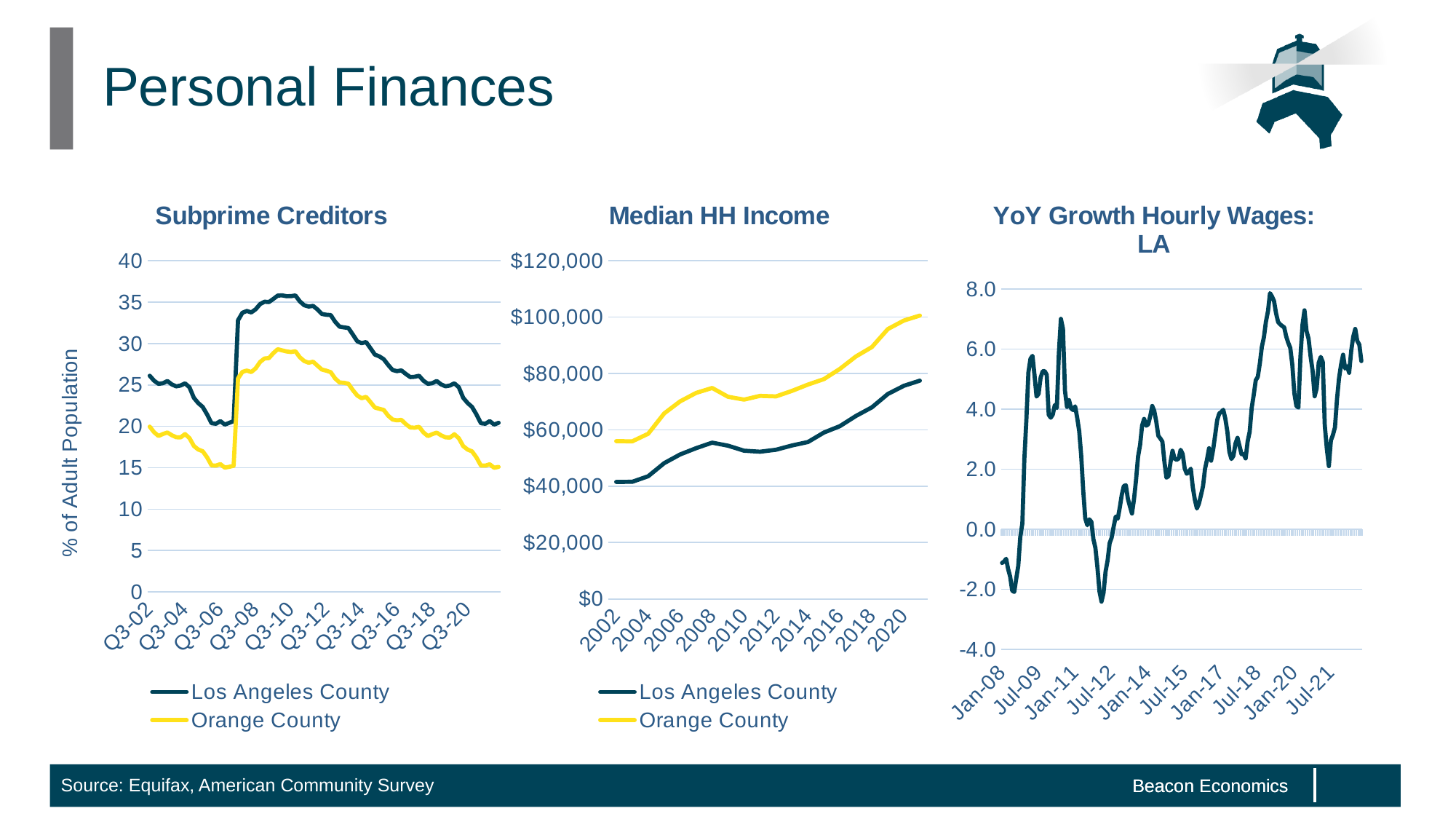
In the Median HH Income chart, does the Los Angeles County line generally rise or fall from 2002 to 2020? rise In the Subprime Creditors chart, is the value for Orange County at Q3-06 greater or less than 20? less In the Subprime Creditors chart, is the value for Los Angeles County at Q3-10 greater or less than 30? greater How many series does the legend of the Median HH Income chart list? 2 In the Median HH Income chart, is the value for Los Angeles County in 2020 greater or less than $60,000? greater In the Median HH Income chart, which series is higher in 2020, Los Angeles County or Orange County? Orange County How many charts are shown on the slide? 3 What is the y-axis label of the Subprime Creditors chart? % of Adult Population What kind of chart is the Subprime Creditors chart? line chart In the Subprime Creditors chart, which series has the higher value at Q3-10, Los Angeles County or Orange County? Los Angeles County